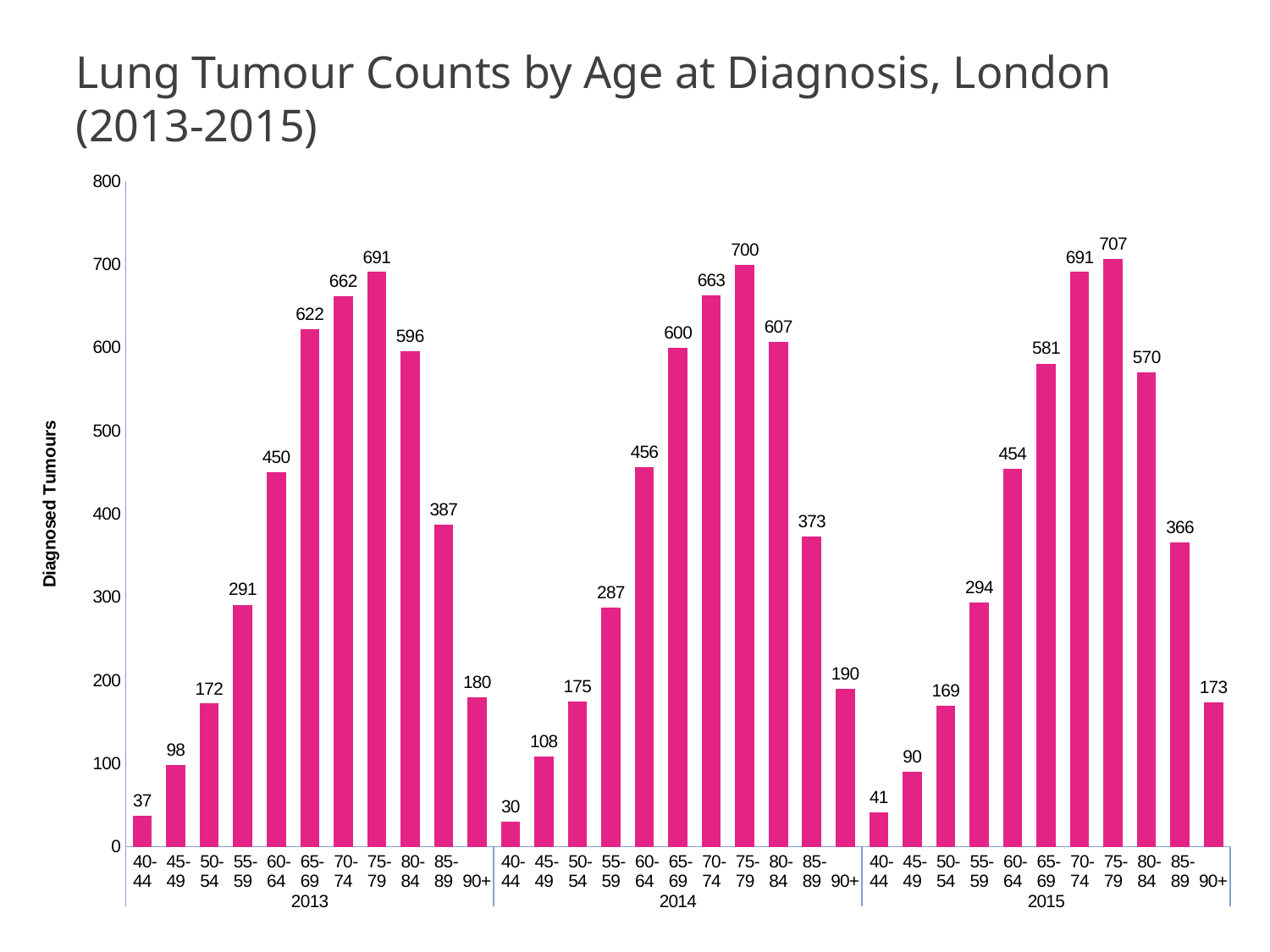
What is the label of the vertical axis? Diagnosed Tumours Is the value for the 60-64 age group in 2014 greater or less than 400? greater Within 2013, do the values rise or fall from the 40-44 age group to the 75-79 age group? Rise What is the number of diagnosed lung tumours for the 40-44 age group in 2013? 37 What is the difference between the 75-79 age group counts in 2015 and 2013? 16 What is the number of diagnosed lung tumours for the 90+ age group in 2015? 173 What is the number of diagnosed lung tumours for the 75-79 age group in 2014? 700 Which year and age group has the highest number of diagnosed tumours on the chart? 75-79 in 2015 Which is larger: the 85-89 count in 2013 or the 85-89 count in 2014? 85-89 in 2013 What kind of chart is shown on the slide? Bar chart Which year and age group has the lowest number of diagnosed tumours on the chart? 40-44 in 2014 How many age groups are shown for each year? 11